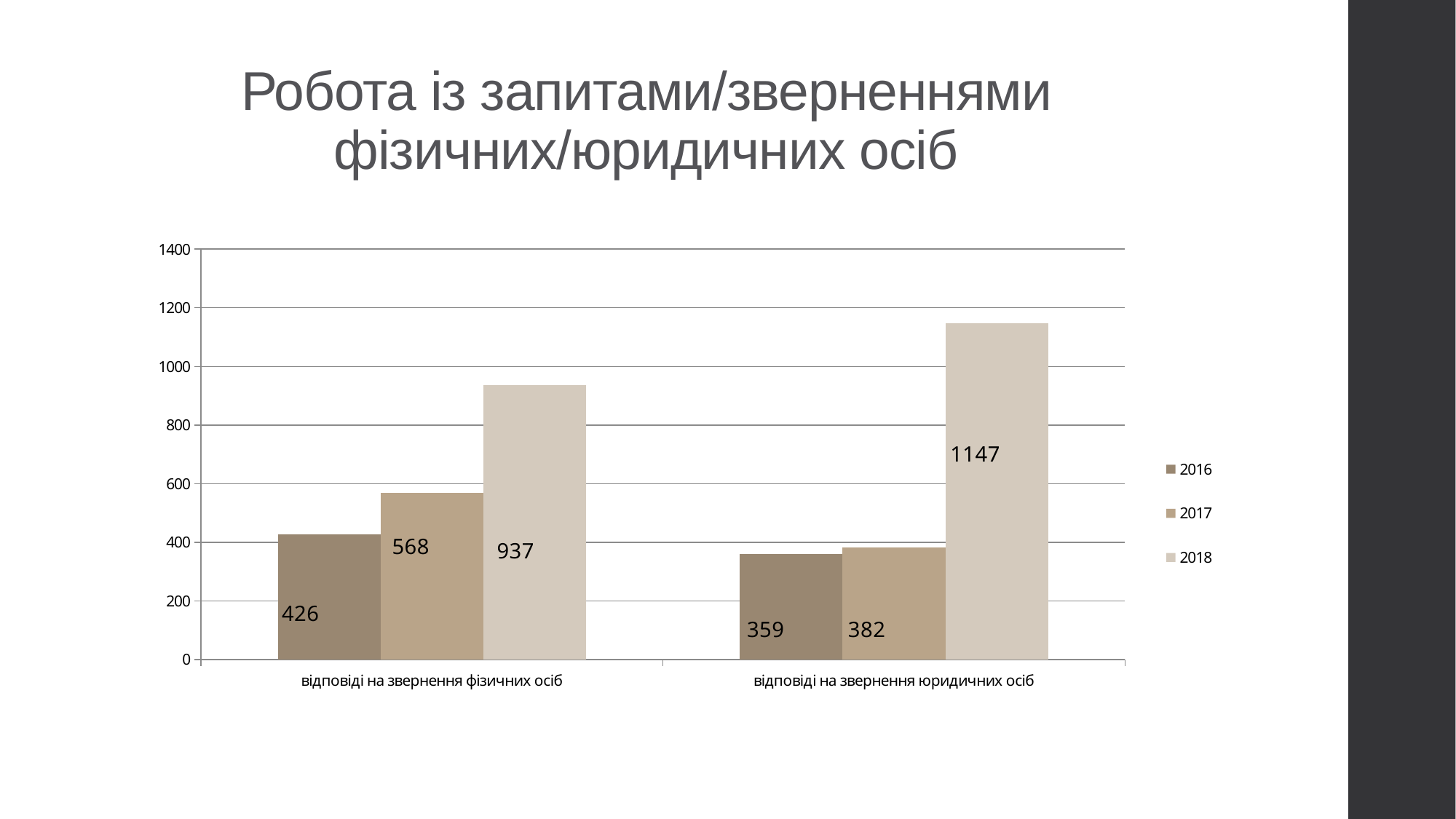
What is the value for 2017 in the category "відповіді на звернення фізичних осіб"? 568 What is the value for 2018 in the category "відповіді на звернення юридичних осіб"? 1147 Which year has the lowest value in the category "відповіді на звернення фізичних осіб"? 2016 Which is larger: the 2016 value for "відповіді на звернення фізичних осіб" or the 2016 value for "відповіді на звернення юридичних осіб"? відповіді на звернення фізичних осіб How many series does the legend list? 3 What kind of chart is shown on the slide? bar chart How many categories are shown on the x axis? 2 What is the difference between the 2018 and 2017 values in the category "відповіді на звернення юридичних осіб"? 765 What is the value for 2016 in the category "відповіді на звернення фізичних осіб"? 426 Do the values for "відповіді на звернення юридичних осіб" rise or fall from 2016 to 2018? rise Which year has the highest value in the category "відповіді на звернення юридичних осіб"? 2018 What is the difference between the 2018 and 2016 values in the category "відповіді на звернення фізичних осіб"? 511